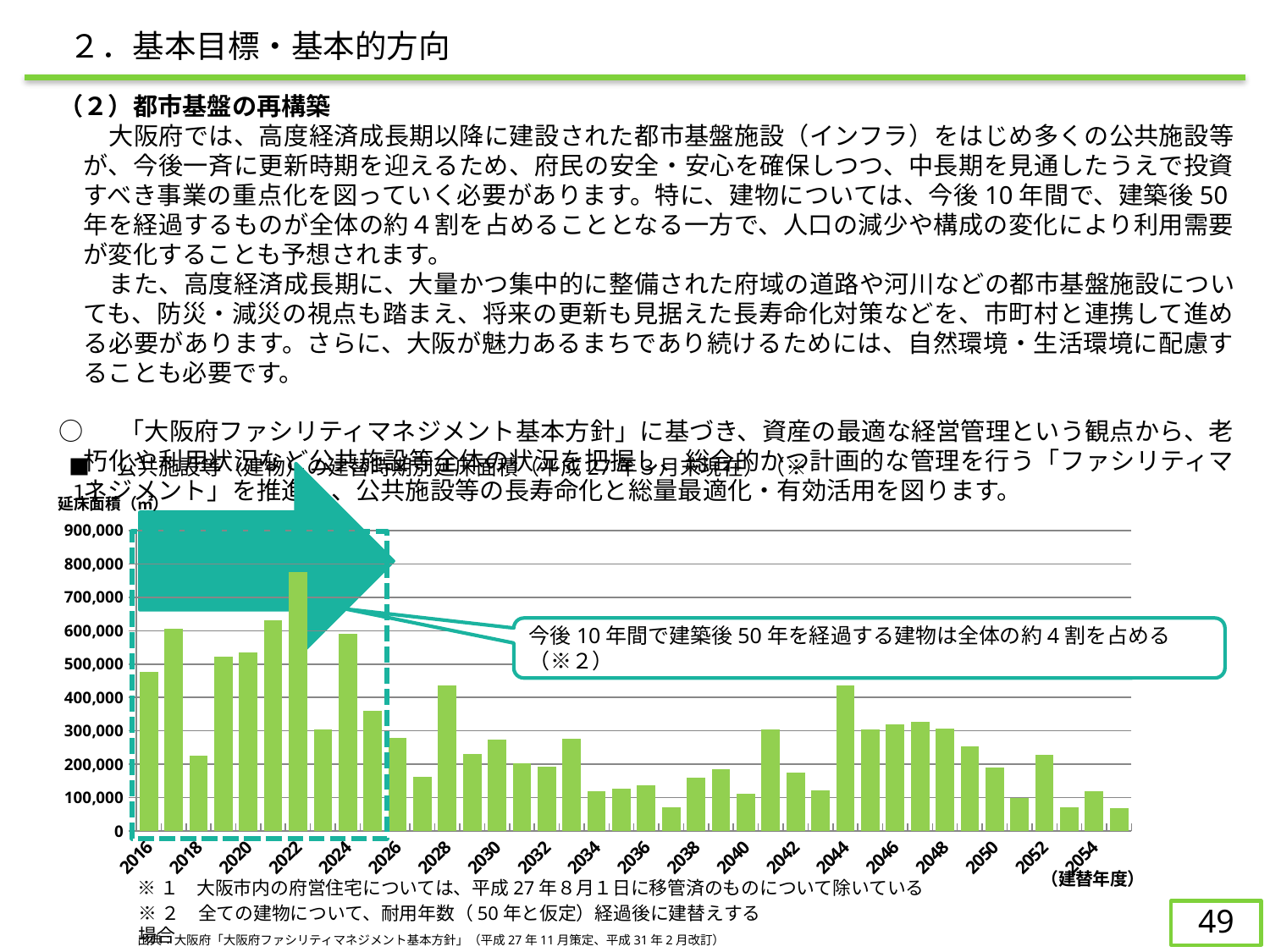
Is the floor area for 2044 greater or less than 400,000? greater Is the floor area for 2016 greater or less than 400,000? greater Is the floor area for 2018 greater or less than 300,000? less Which has the larger floor area, 2022 or 2024? 2022 Which rebuild year (建替年度) has the highest floor area in the chart? 2022 What is the label on the vertical axis of the chart? 延床面積（㎡） What is the highest tick value shown on the vertical axis? 900,000 Which has the larger floor area, 2028 or 2030? 2028 Which has the larger floor area, 2017 or 2018? 2017 What kind of chart is shown on the slide? bar chart